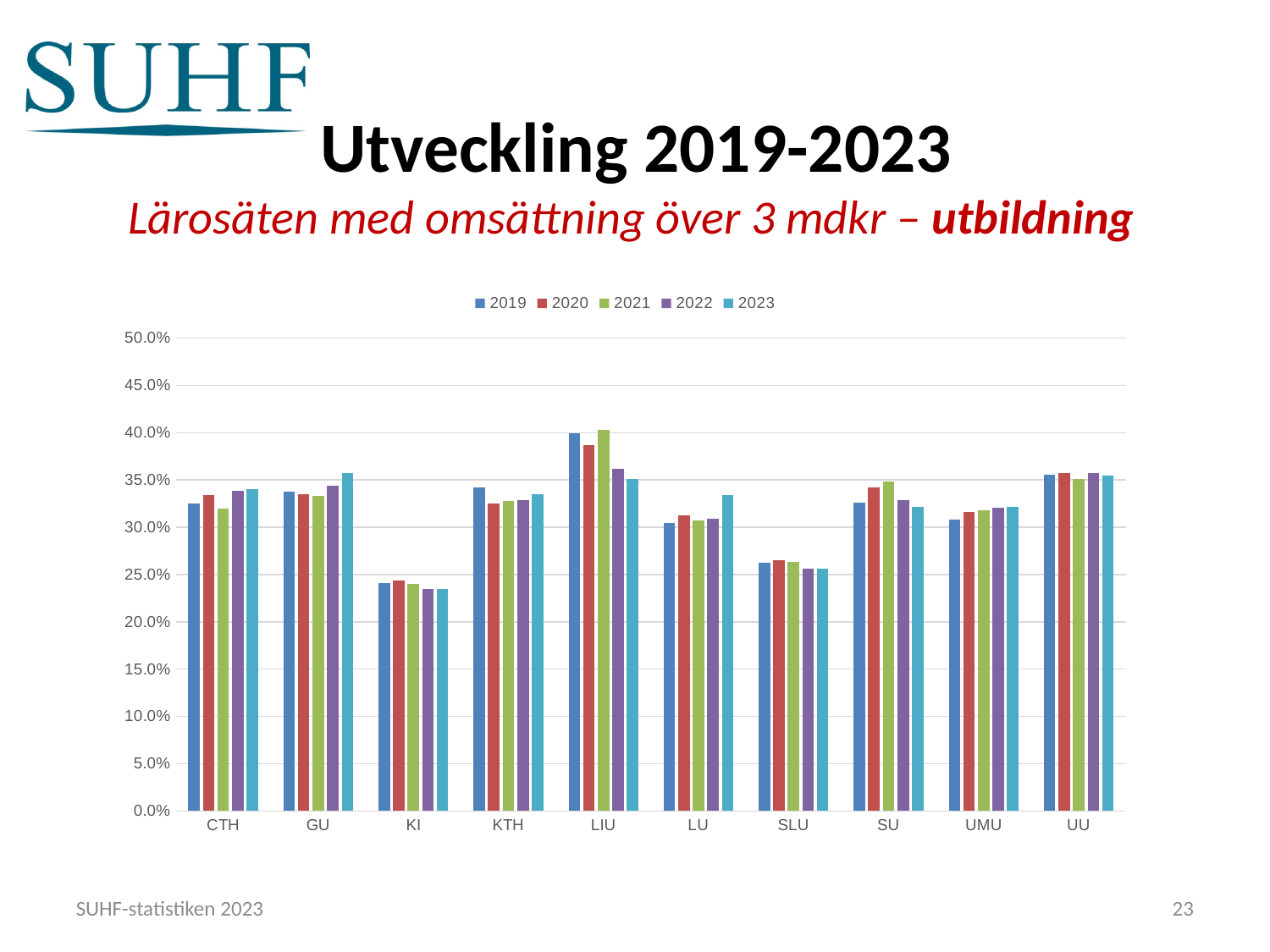
Which is larger, the 2019 value for LIU or the 2019 value for LU? LIU Is the value for KI in 2023 greater or less than 25.0%? less Does the value for GU rise or fall from 2019 to 2023? rise Which years are listed in the chart legend? 2019, 2020, 2021, 2022, 2023 How many institutions (categories) are shown on the x axis? 10 Is the value for KTH in 2019 greater or less than 35.0%? less Which is larger, the 2023 value for GU or the 2023 value for KTH? GU Which institution has the highest values across the years shown? LIU How many series does the legend list? 5 Which institution has the lowest values across the years shown? KI What kind of chart is shown on the slide? bar chart Is the value for LIU in 2022 greater or less than 35.0%? greater